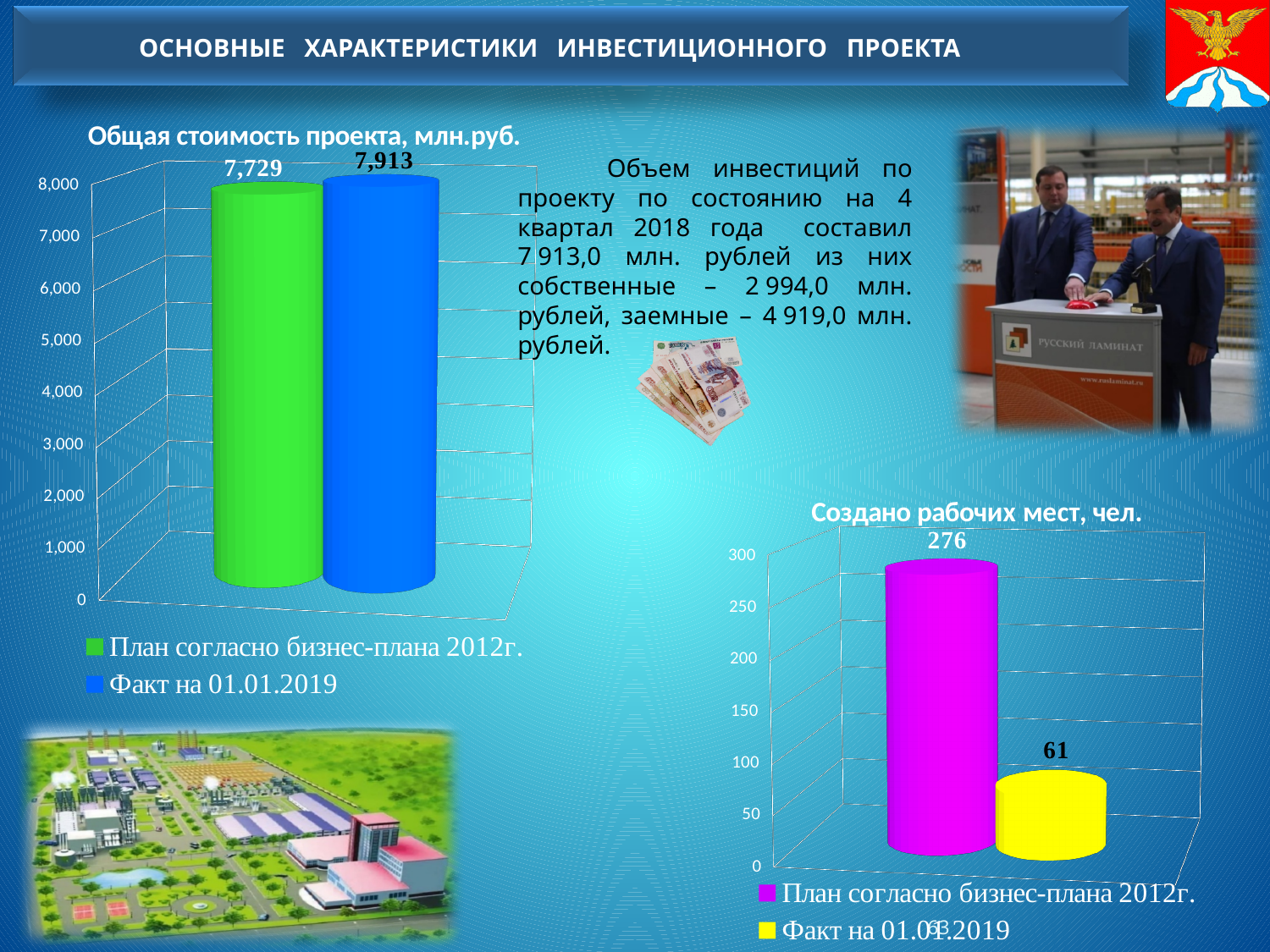
On the chart 'Создано рабочих мест, чел.', what is the difference between the 'План согласно бизнес-плана 2012г.' value and the 'Факт на 01.01.2019' value? 215 What kind of chart is 'Общая стоимость проекта, млн.руб.'? Bar chart On the chart 'Общая стоимость проекта, млн.руб.', which is larger: 'План согласно бизнес-плана 2012г.' or 'Факт на 01.01.2019'? Факт на 01.01.2019 On the chart 'Создано рабочих мест, чел.', what is the value for 'План согласно бизнес-плана 2012г.'? 276 On the chart 'Создано рабочих мест, чел.', what colour is the bar for 'План согласно бизнес-плана 2012г.'? Magenta On the chart 'Общая стоимость проекта, млн.руб.', how many series does the legend list? 2 On the chart 'Создано рабочих мест, чел.', which series has the lowest value? Факт на 01.01.2019 On the chart 'Создано рабочих мест, чел.', is the value for 'Факт на 01.01.2019' greater or less than 100? less On the chart 'Общая стоимость проекта, млн.руб.', what is the value for 'Факт на 01.01.2019'? 7,913 On the chart 'Создано рабочих мест, чел.', what is the value for 'Факт на 01.01.2019'? 61 On the chart 'Общая стоимость проекта, млн.руб.', what is the value for 'План согласно бизнес-плана 2012г.'? 7,729 On the chart 'Общая стоимость проекта, млн.руб.', what is the difference between the 'Факт на 01.01.2019' value and the 'План согласно бизнес-плана 2012г.' value? 184